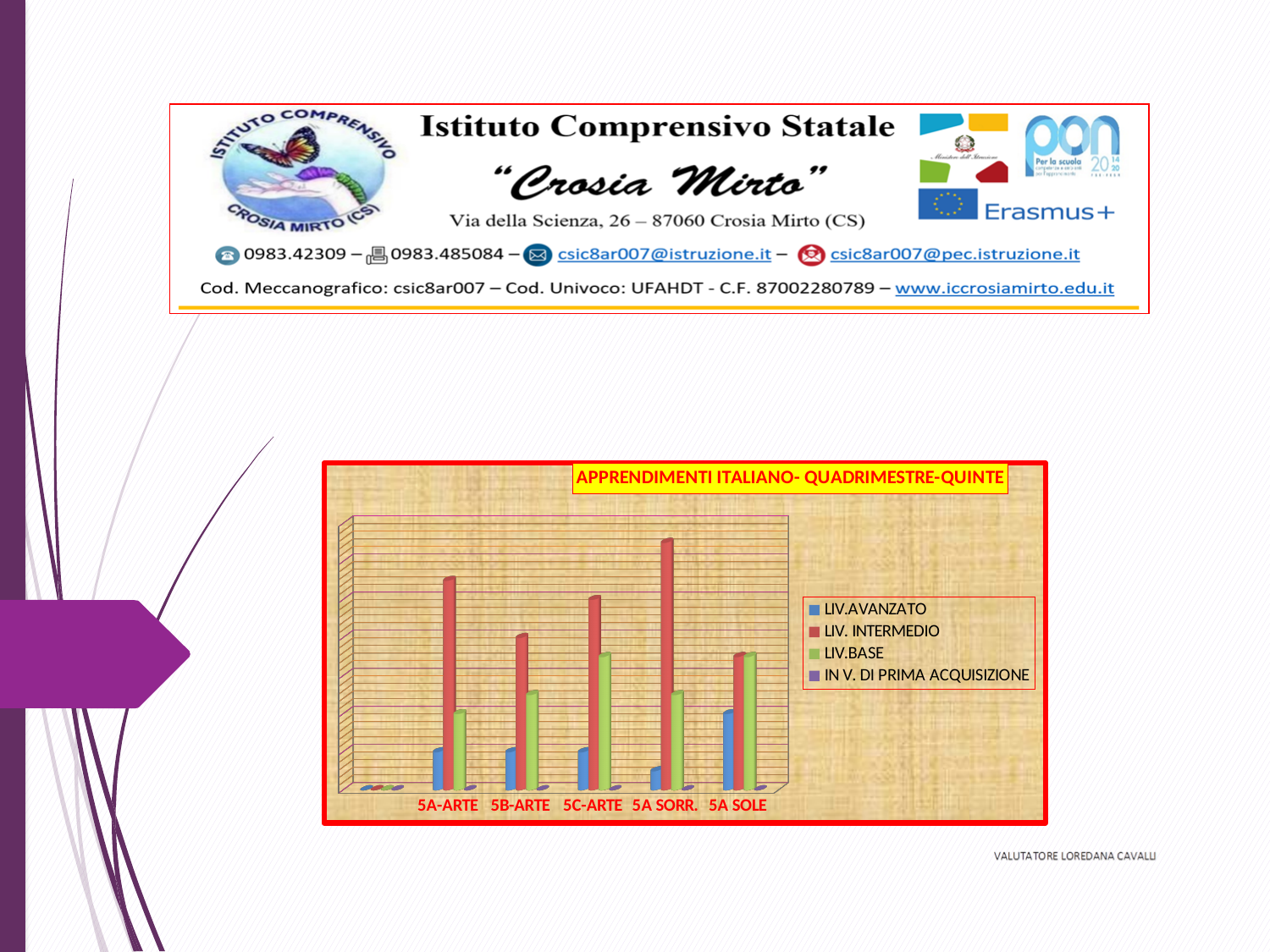
What is the title of the chart? APPRENDIMENTI ITALIANO- QUADRIMESTRE-QUINTE For 5A-ARTE, which is larger: LIV. INTERMEDIO or LIV.BASE? LIV. INTERMEDIO Which series is shown in green in the chart? LIV.BASE Which class has the lowest value for LIV.AVANZATO? 5A SORR. How many classes (categories) are shown on the x axis of the chart? 5 Which class has the lowest value for LIV. INTERMEDIO? 5A SOLE How many series does the chart legend list? 4 What kind of chart is shown on the slide? Bar chart Which class has the highest value for LIV.AVANZATO? 5A SOLE Which class has the highest value for LIV. INTERMEDIO? 5A SORR. Which is larger: LIV. INTERMEDIO for 5A SORR. or LIV. INTERMEDIO for 5C-ARTE? 5A SORR.